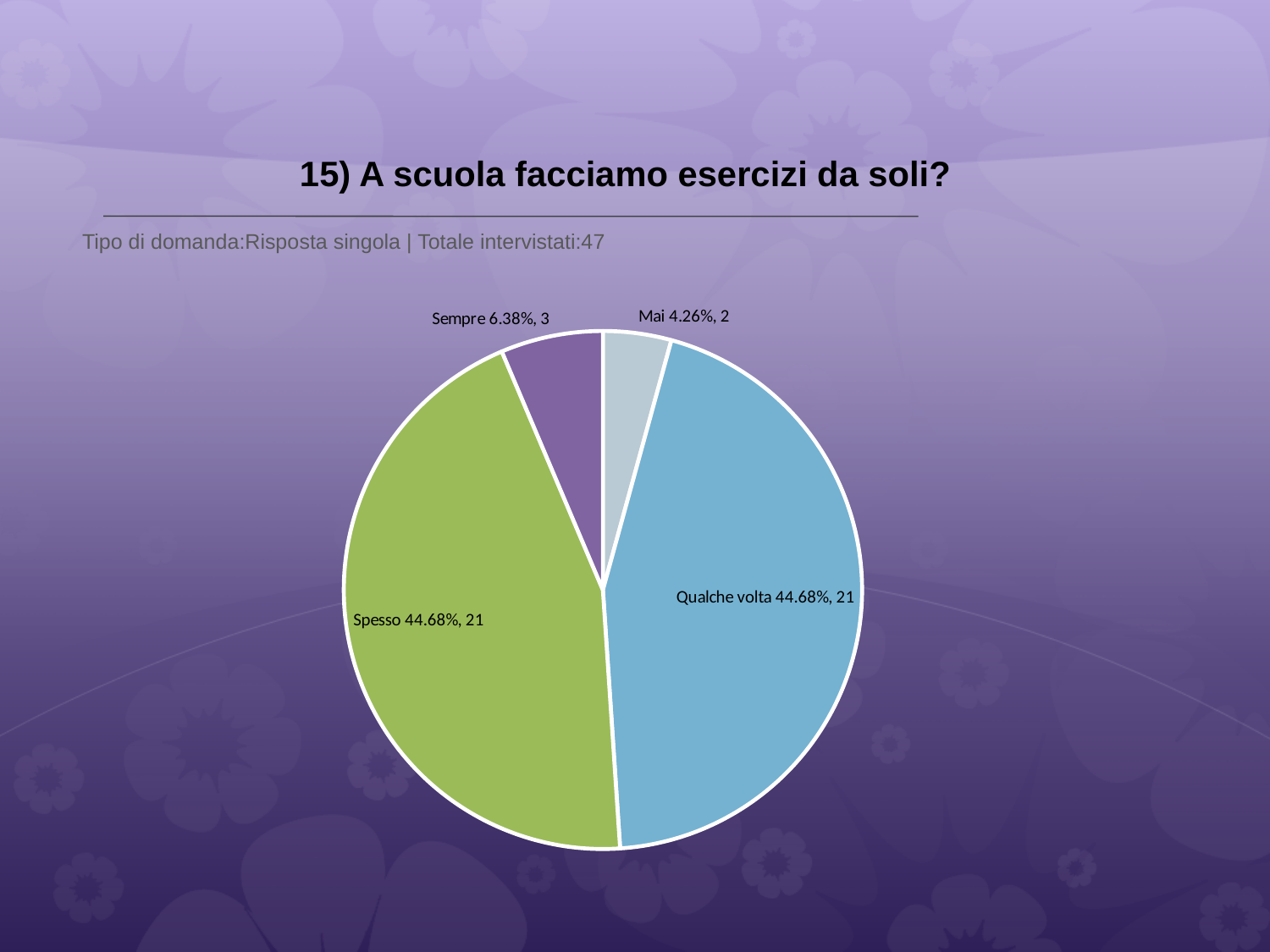
What share of the pie does "Spesso" represent? 44.68% What is the title of the chart on the slide? 15) A scuola facciamo esercizi da soli? How many respondents answered "Mai"? 2 Which slice is larger, "Sempre" or "Mai"? Sempre What percentage of respondents answered "Qualche volta"? 44.68% How many slices does the pie chart have? 4 What kind of chart is shown on the slide? pie chart What is the difference in percentage points between "Qualche volta" and "Sempre"? 38.30 How many respondents answered "Spesso"? 21 How many more respondents answered "Sempre" than "Mai"? 1 What percentage of respondents answered "Sempre"? 6.38% Which answer has the smallest slice of the pie? Mai